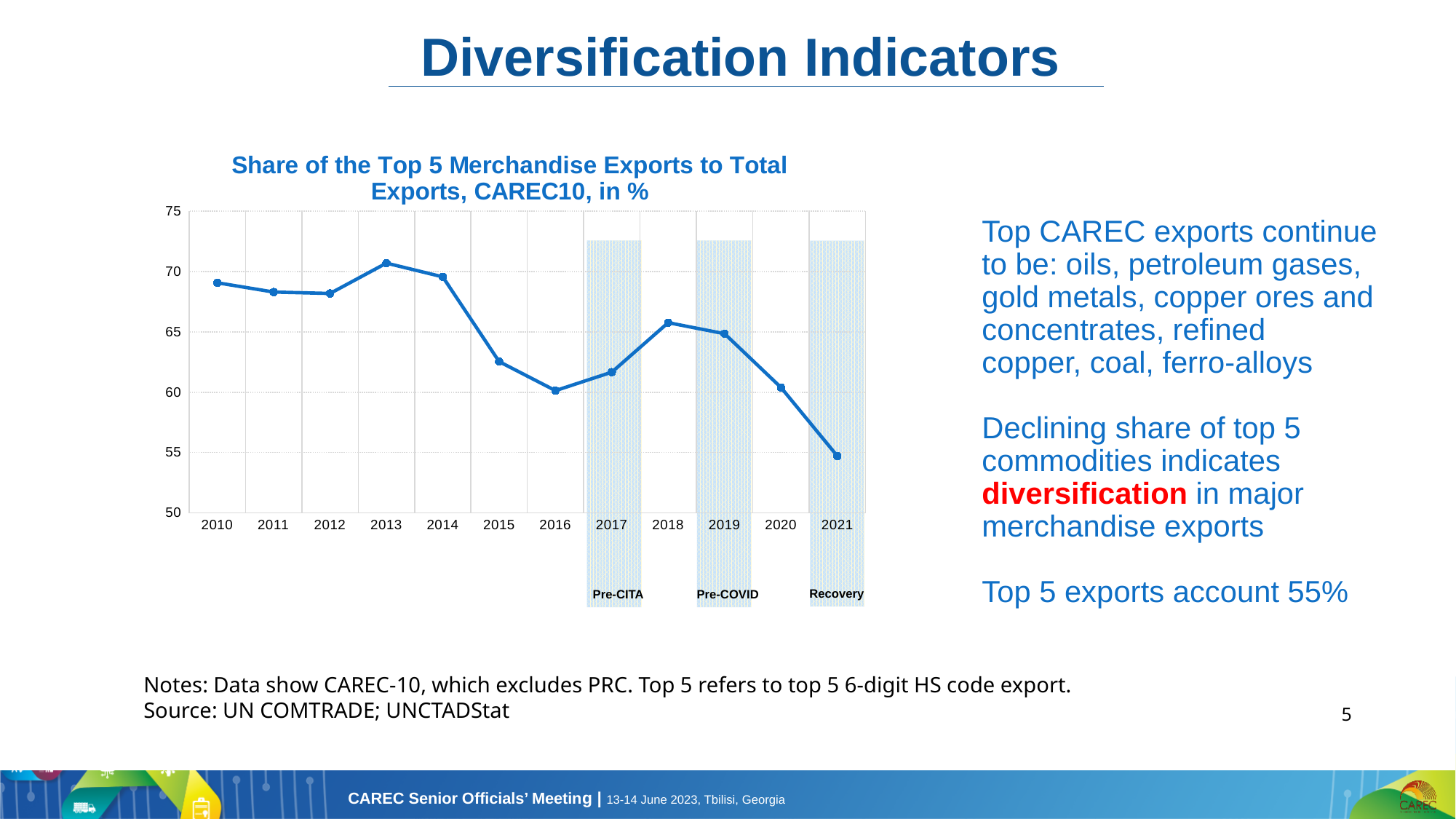
Is the value for 2010 greater or less than 70? less Does the share of top 5 exports generally rise or fall from 2010 to 2021? Fall What labels are given to the three shaded periods on the chart? Pre-CITA, Pre-COVID, Recovery Which year has the highest share of top 5 merchandise exports? 2013 Which year has a higher value, 2010 or 2021? 2010 What is the title of the chart? Share of the Top 5 Merchandise Exports to Total Exports, CAREC10, in % How many years are plotted on the x axis of the chart? 12 What kind of chart is shown on the slide? Line chart Which year has the lowest share of top 5 merchandise exports? 2021 Is the value for 2015 greater or less than 60? greater Is the value for 2013 greater or less than 70? greater